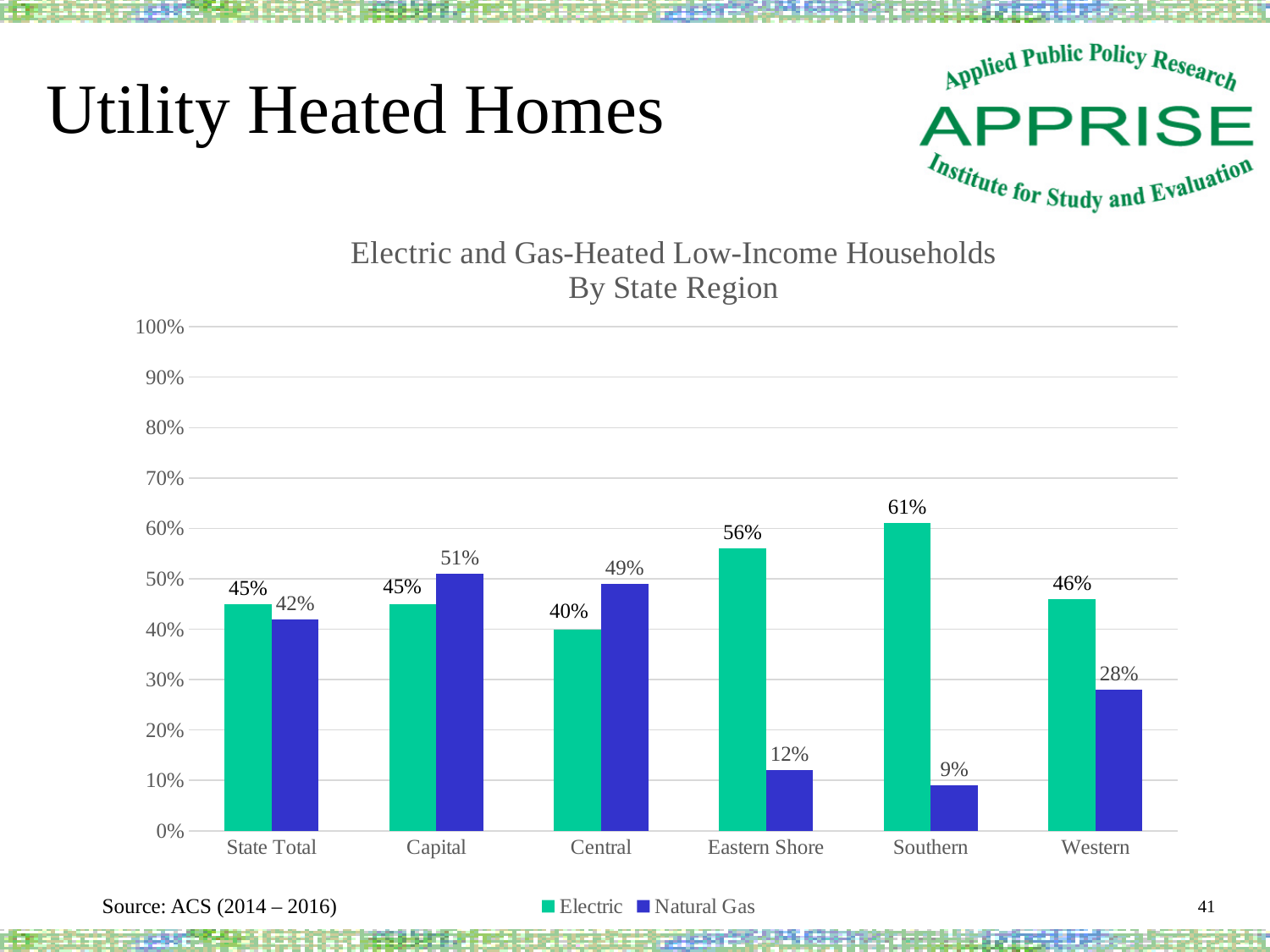
Which is larger for Capital, the Electric value or the Natural Gas value? Natural Gas What is the Natural Gas value for Eastern Shore? 12% What is the Natural Gas value for Western? 28% What is the title of the chart? Electric and Gas-Heated Low-Income Households By State Region How many series does the legend list? 2 What kind of chart is shown on the slide? Bar chart Which region has the highest Electric value? Southern How many regions are shown on the x axis? 6 Is the Electric value for Eastern Shore greater or less than 50%? greater Which region has the lowest Natural Gas value? Southern What is the difference between the Electric and Natural Gas values for Southern? 52% What is the Electric value for Southern? 61%